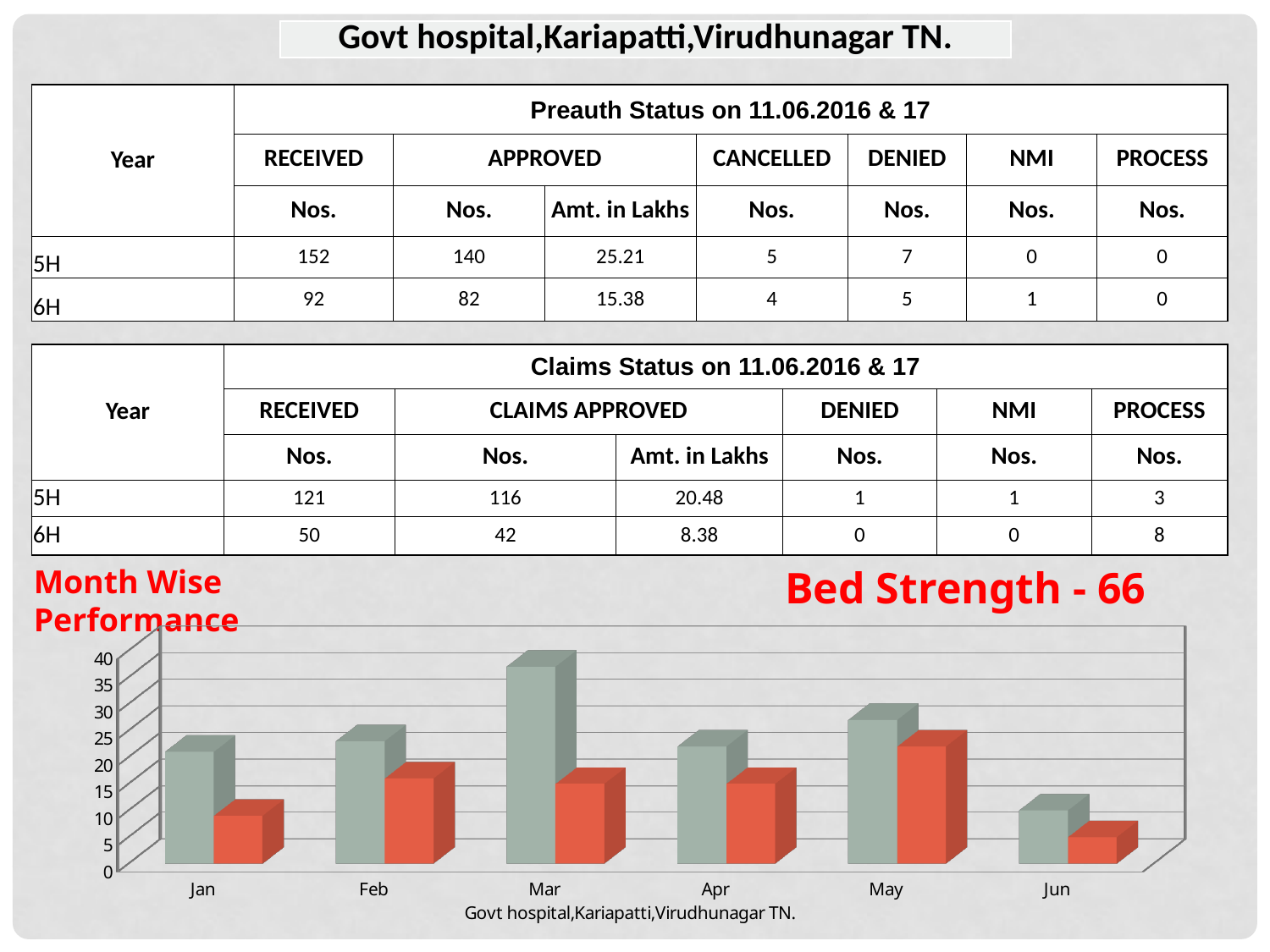
In the Month Wise Performance chart, which is larger: the grey bar for Mar or the grey bar for Feb? Mar In the Month Wise Performance chart, which month has the shortest orange bar? Jun In the Month Wise Performance chart, which month has the shortest grey bar? Jun What kind of chart is shown under the heading "Month Wise Performance"? bar chart In the Month Wise Performance chart, which month has the tallest orange bar? May In the Month Wise Performance chart, is the grey bar for Mar greater or less than 30? greater In the Month Wise Performance chart, is the orange bar for Jan greater or less than 15? less How many months are shown on the x axis of the Month Wise Performance chart? 6 What text appears as the axis title below the months in the Month Wise Performance chart? Govt hospital,Kariapatti,Virudhunagar TN. In the Month Wise Performance chart, which month has the tallest grey bar? Mar In the Month Wise Performance chart, which is larger for Jan: the grey bar or the orange bar? the grey bar In the Month Wise Performance chart, is the grey bar for Jun greater or less than 15? less